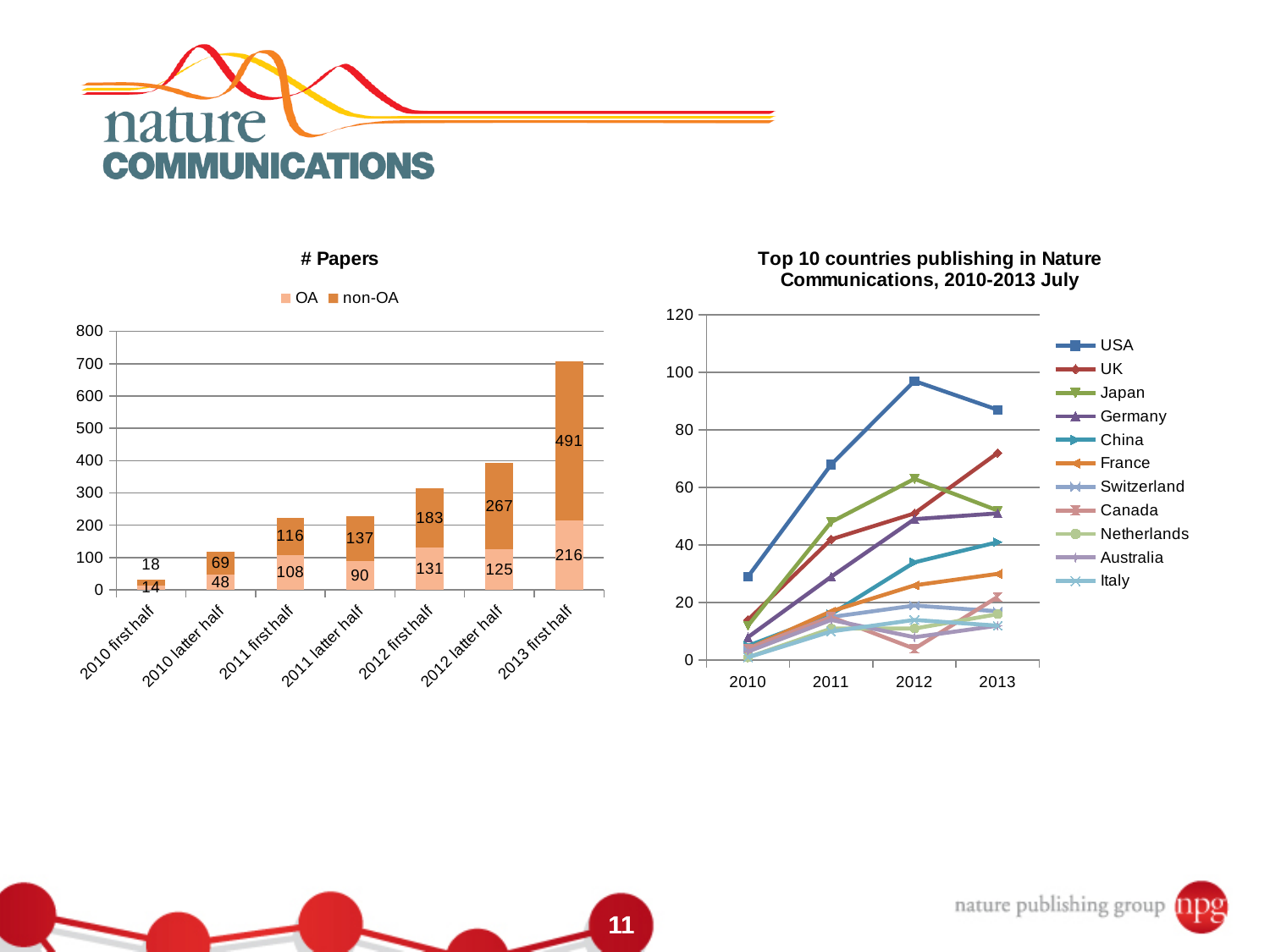
In the '# Papers' chart, what is the OA value for 2011 latter half? 90 In the 'Top 10 countries publishing in Nature Communications' chart, is the value for USA in 2012 greater or less than 80? greater How many countries does the legend of the 'Top 10 countries publishing in Nature Communications' chart list? 11 In the '# Papers' chart, which period has the lowest OA value? 2010 first half In the '# Papers' chart, which period has the highest non-OA value? 2013 first half In the 'Top 10 countries publishing in Nature Communications' chart, which country has the highest value in 2013? USA How many periods are shown on the x axis of the '# Papers' chart? 7 In the '# Papers' chart, what is the total number of papers for 2012 latter half (OA plus non-OA)? 392 In the '# Papers' chart, what is the non-OA value for 2013 first half? 491 In the '# Papers' chart, is the OA value larger for 2011 first half or 2011 latter half? 2011 first half In the '# Papers' chart, what is the difference between the non-OA and OA values for 2012 first half? 52 What kind of chart is the 'Top 10 countries publishing in Nature Communications, 2010-2013 July' chart? line chart